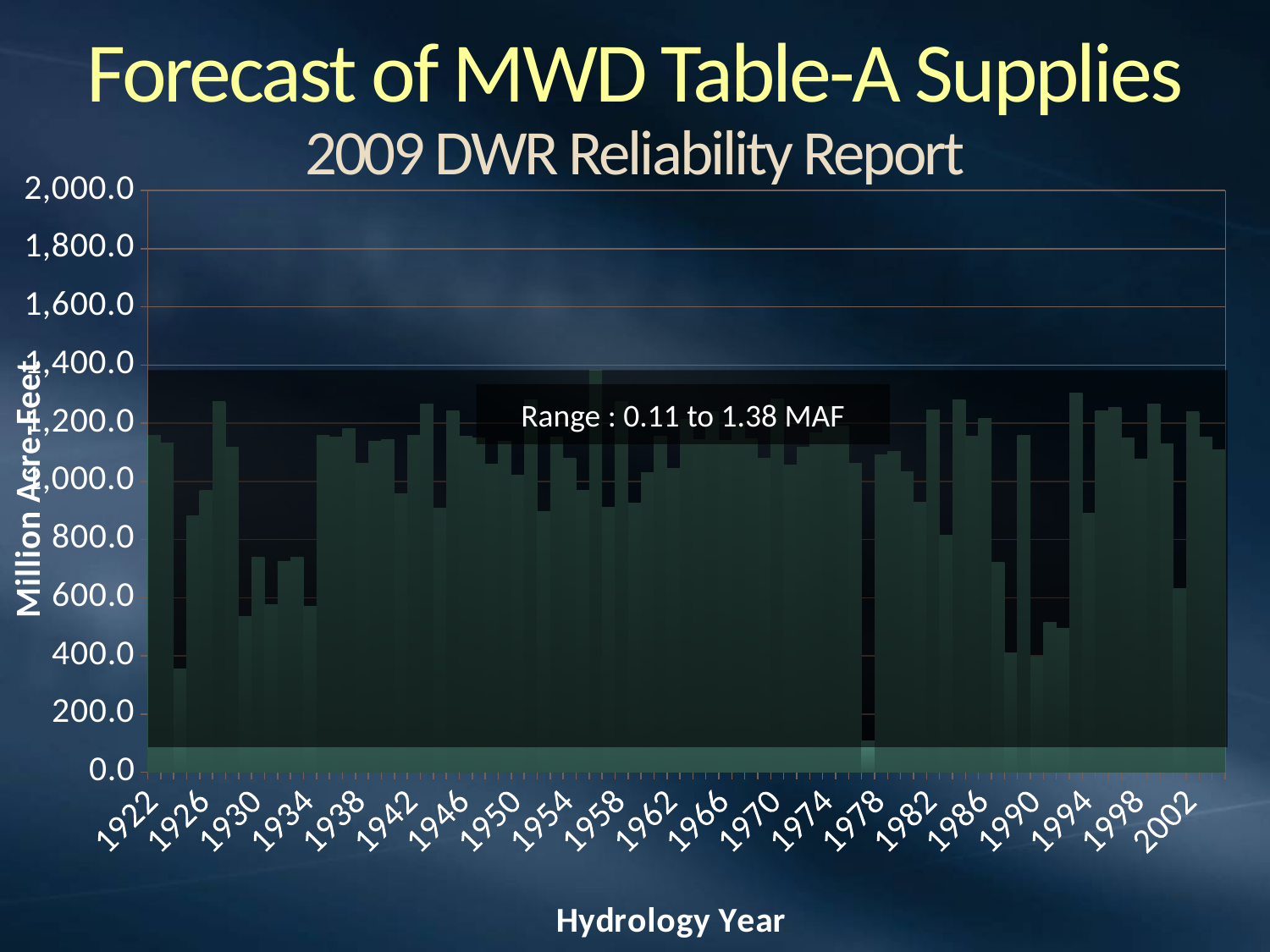
What kind of chart is shown on the slide? bar chart Is the value for hydrology year 1990 greater or less than 600.0? less Is the value for hydrology year 2002 greater or less than 1,000.0? greater Is the value for hydrology year 1998 greater or less than 1,000.0? greater Which hydrology year has the larger value, 1934 or 1946? 1946 What range of values does the annotation on the chart state? 0.11 to 1.38 MAF Which hydrology year has the larger value, 1922 or 1990? 1922 What is the title of the chart on the slide? Forecast of MWD Table-A Supplies